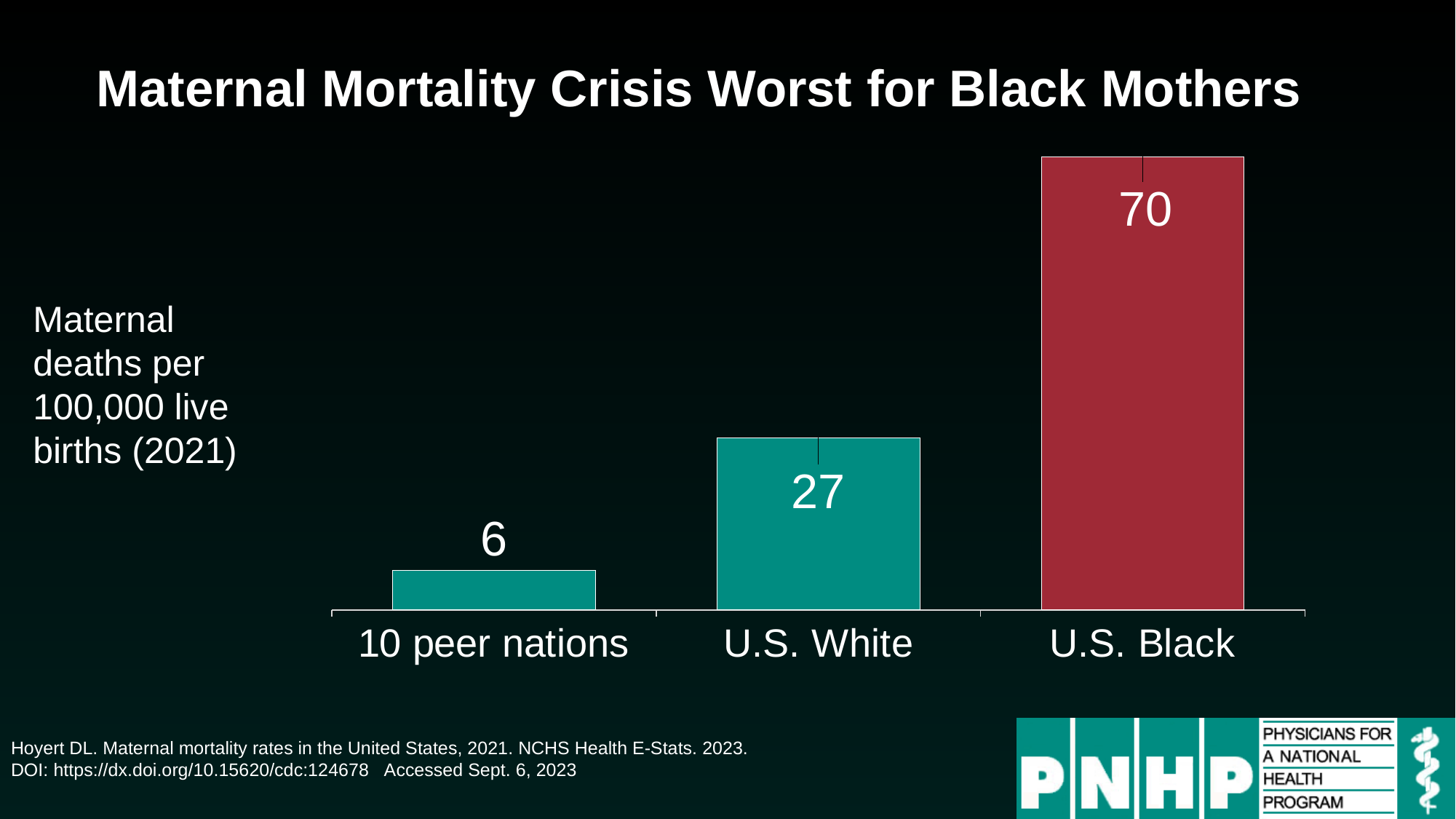
What kind of chart is shown on the slide? Bar chart What is the maternal mortality value for U.S. Black mothers? 70 What is the difference between the U.S. White value and the 10 peer nations value? 21 Which category has the highest maternal mortality rate? U.S. Black Which category has the lowest maternal mortality rate? 10 peer nations What is the maternal mortality value for the 10 peer nations? 6 What is the difference between the U.S. Black and U.S. White values? 43 How many categories are shown on the chart? 3 Which is larger, the value for U.S. White or the value for 10 peer nations? U.S. White What is the title of the chart? Maternal Mortality Crisis Worst for Black Mothers Do the values rise or fall from left to right across the categories? Rise What is the maternal mortality value for U.S. White mothers? 27